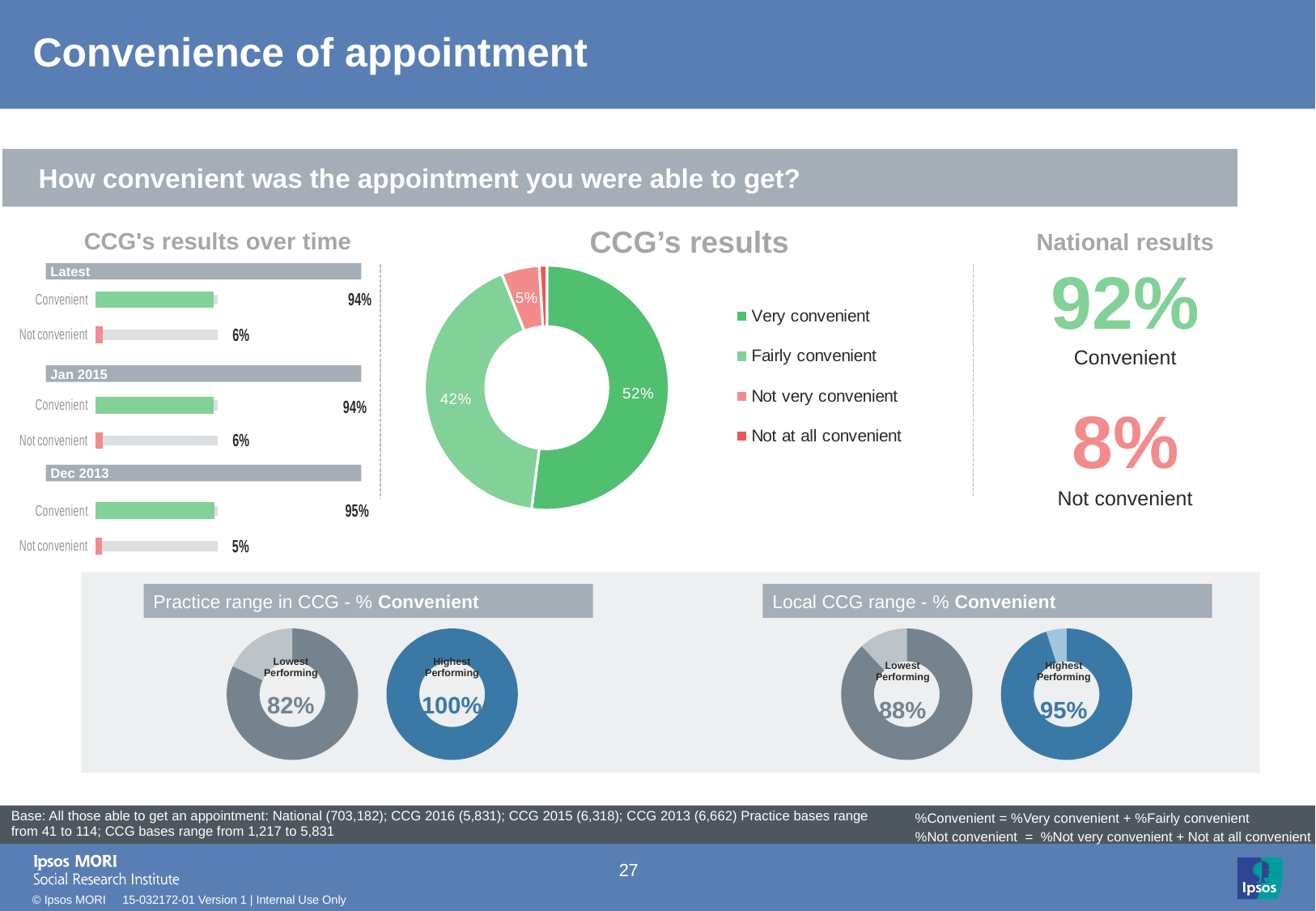
In the 'CCG's results over time' chart, what is the value for Not convenient in Dec 2013? 5% In the 'CCG's results' donut chart, which category has the largest share? Very convenient In the 'CCG's results' donut chart, what share is Fairly convenient? 42% In the 'CCG's results over time' chart, what is the value for Convenient in the Latest period? 94% In the 'Practice range in CCG - % Convenient' charts, what is the Highest Performing value? 100% In the 'CCG's results over time' chart, what kind of chart is used? Bar chart In the 'CCG's results over time' chart, which period has the highest Convenient value? Dec 2013 How many entries does the legend of the 'CCG's results' donut chart list? 4 In the 'CCG's results' donut chart, what share is Very convenient? 52% In the 'CCG's results over time' chart, what is the difference between the Convenient value in Dec 2013 and the Convenient value in the Latest period? 1% In the 'CCG's results' donut chart, what is the difference between the Very convenient and Fairly convenient shares? 10% In the 'Local CCG range - % Convenient' charts, what is the difference between the Highest Performing and Lowest Performing values? 7%